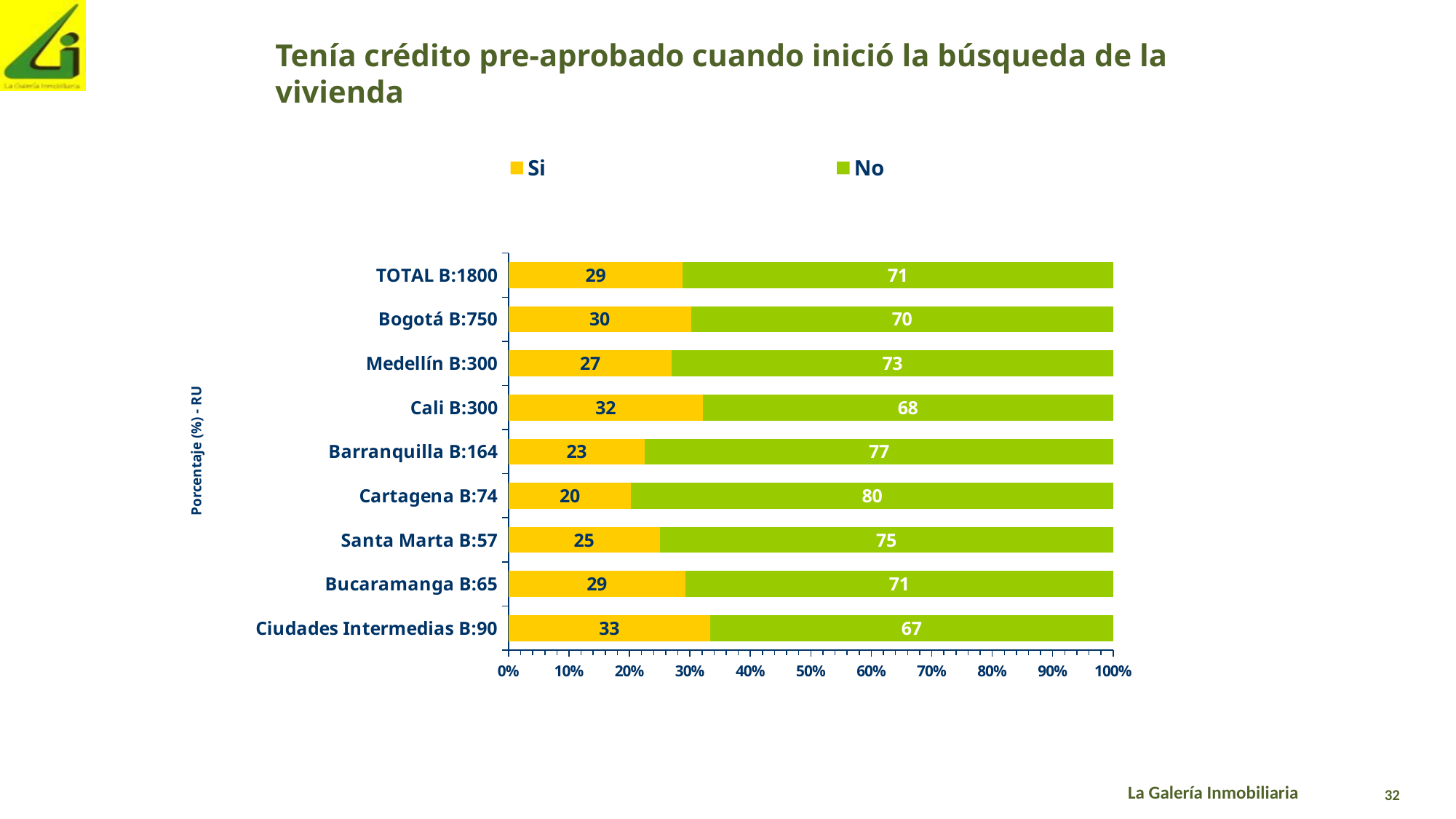
Which category has the lowest "Si" value? Cartagena B:74 What is the "Si" value for Bogotá B:750? 30 What kind of chart is shown on the slide? Stacked bar chart Which has a larger "Si" value, Medellín B:300 or Cali B:300? Cali B:300 What is the total of the stacked bar for Santa Marta B:57? 100 How many series does the legend list? 2 What is the "No" value for Cartagena B:74? 80 Which category has the highest "Si" value? Ciudades Intermedias B:90 What colour represents the "No" series? Green What is the "Si" value for TOTAL B:1800? 29 What is the difference between the "No" values for Barranquilla B:164 and Cali B:300? 9 How many categories are shown on the chart? 9